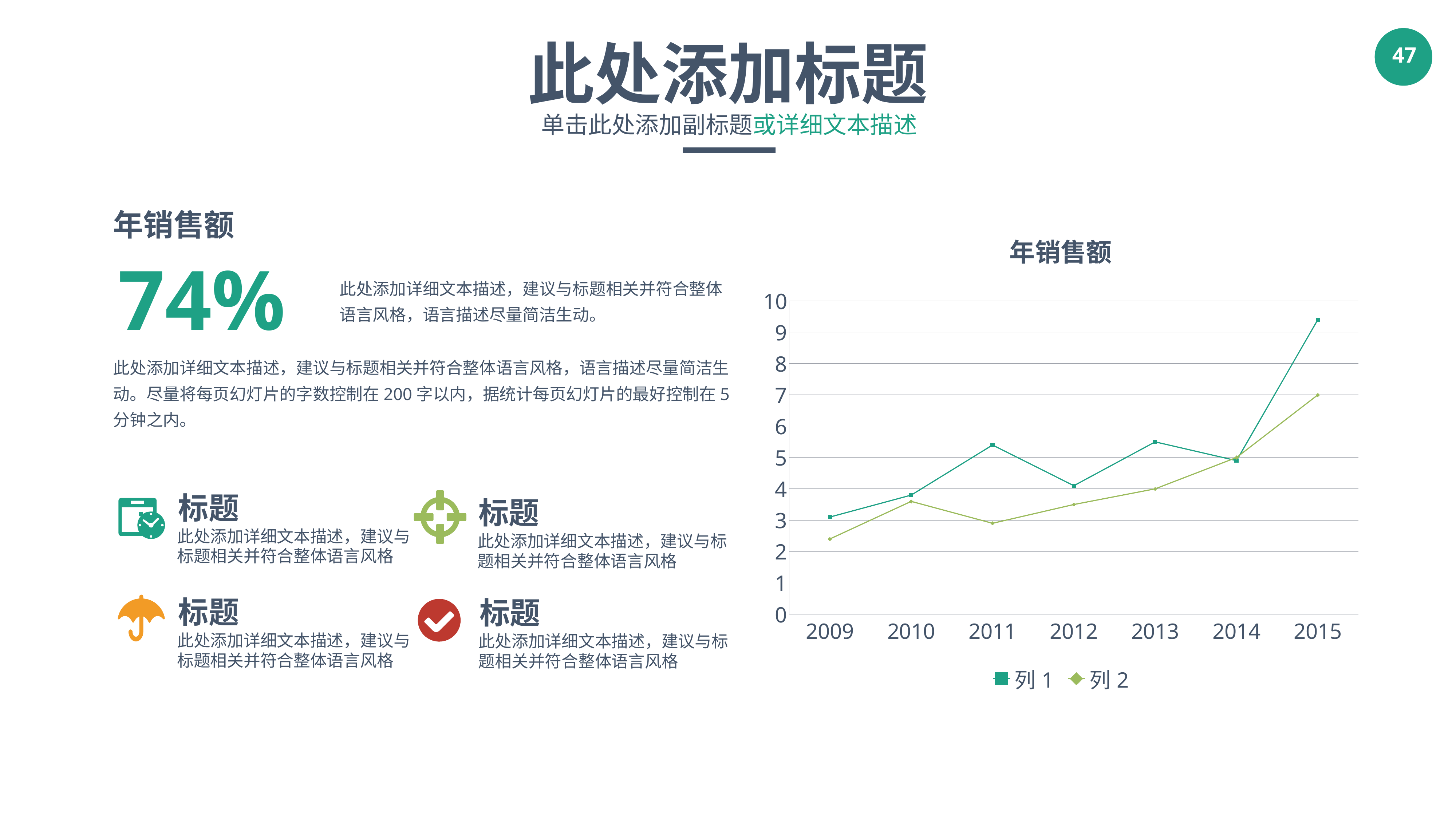
What is the title of the chart? 年销售额 How many series does the chart legend list? 2 Is the value for 列 2 in 2009 greater or less than 3? less In which year does 列 2 have its lowest value? 2009 Does the value of 列 2 rise or fall from 2012 to 2015? rise How many years are plotted along the x axis of the chart? 7 Is the value for 列 1 in 2011 greater or less than 5? greater In which year does 列 1 reach its highest value? 2015 What kind of chart is shown on the slide? line chart What are the two legend entries of the chart? 列 1 and 列 2 Is the value for 列 1 in 2015 greater or less than 9? greater In 2011, which series has the larger value, 列 1 or 列 2? 列 1